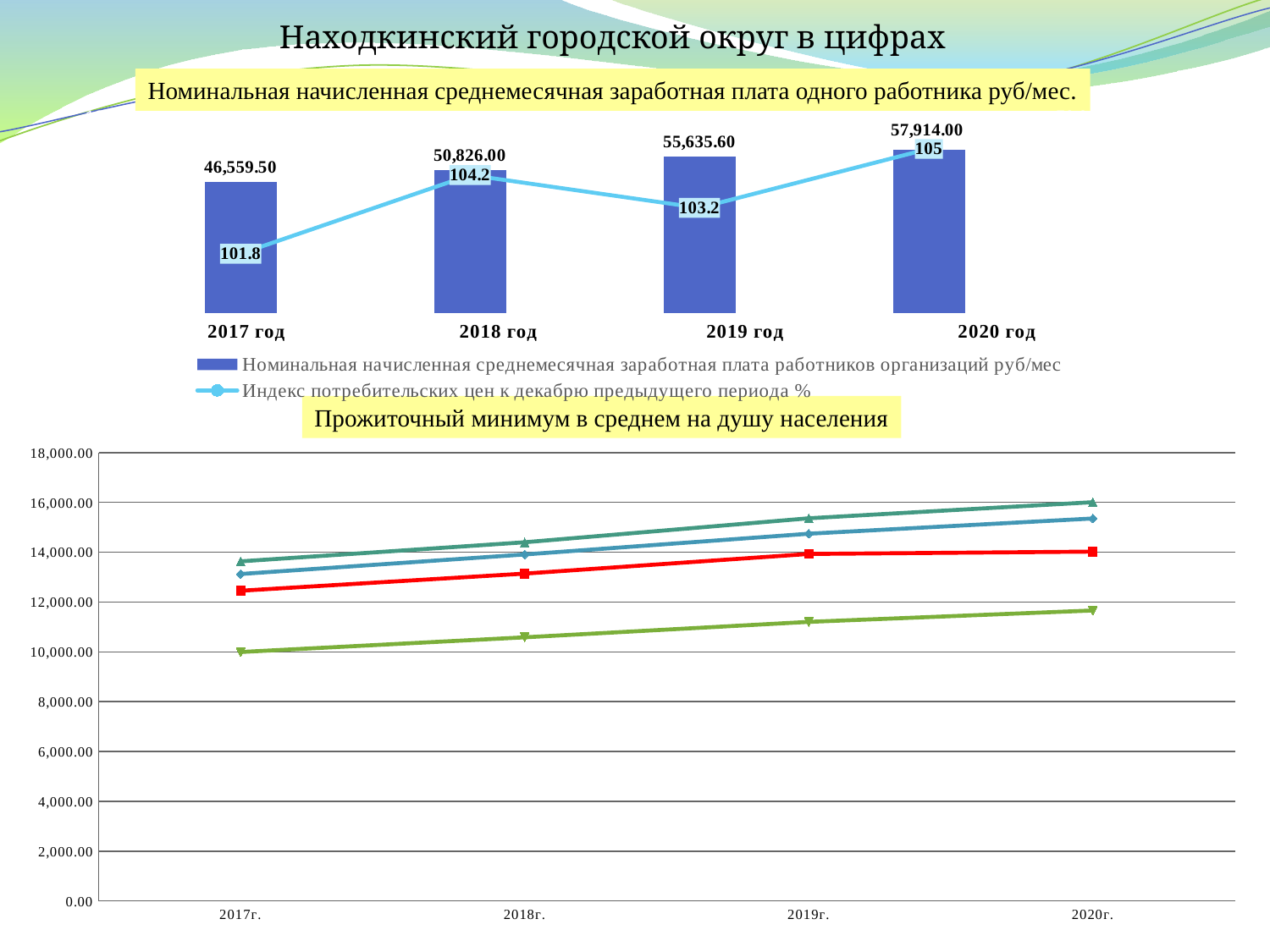
In the top chart, which is larger: the consumer price index in 2018 год or in 2019 год? 2018 год In the top chart, what is the consumer price index value for 2018 год? 104.2 In the top chart, what is the nominal average monthly wage for 2017 год? 46,559.50 What kind of chart is the bottom chart (Прожиточный минимум в среднем на душу населения)? line chart In the bottom chart, do the lines rise or fall from 2017г. to 2020г.? rise In the top chart, what is the difference between the nominal average monthly wage in 2020 год and in 2017 год? 11,354.50 In the top chart (Номинальная начисленная среднемесячная заработная плата), what is the nominal average monthly wage for 2019 год? 55,635.60 In the top chart, which year has the lowest consumer price index value? 2017 год In the bottom chart, how many years are shown on the x axis? 4 In the top chart, do the nominal average monthly wage bars rise or fall from 2017 год to 2020 год? rise In the top chart, how many series does the legend list? 2 In the top chart, which year has the highest nominal average monthly wage? 2020 год